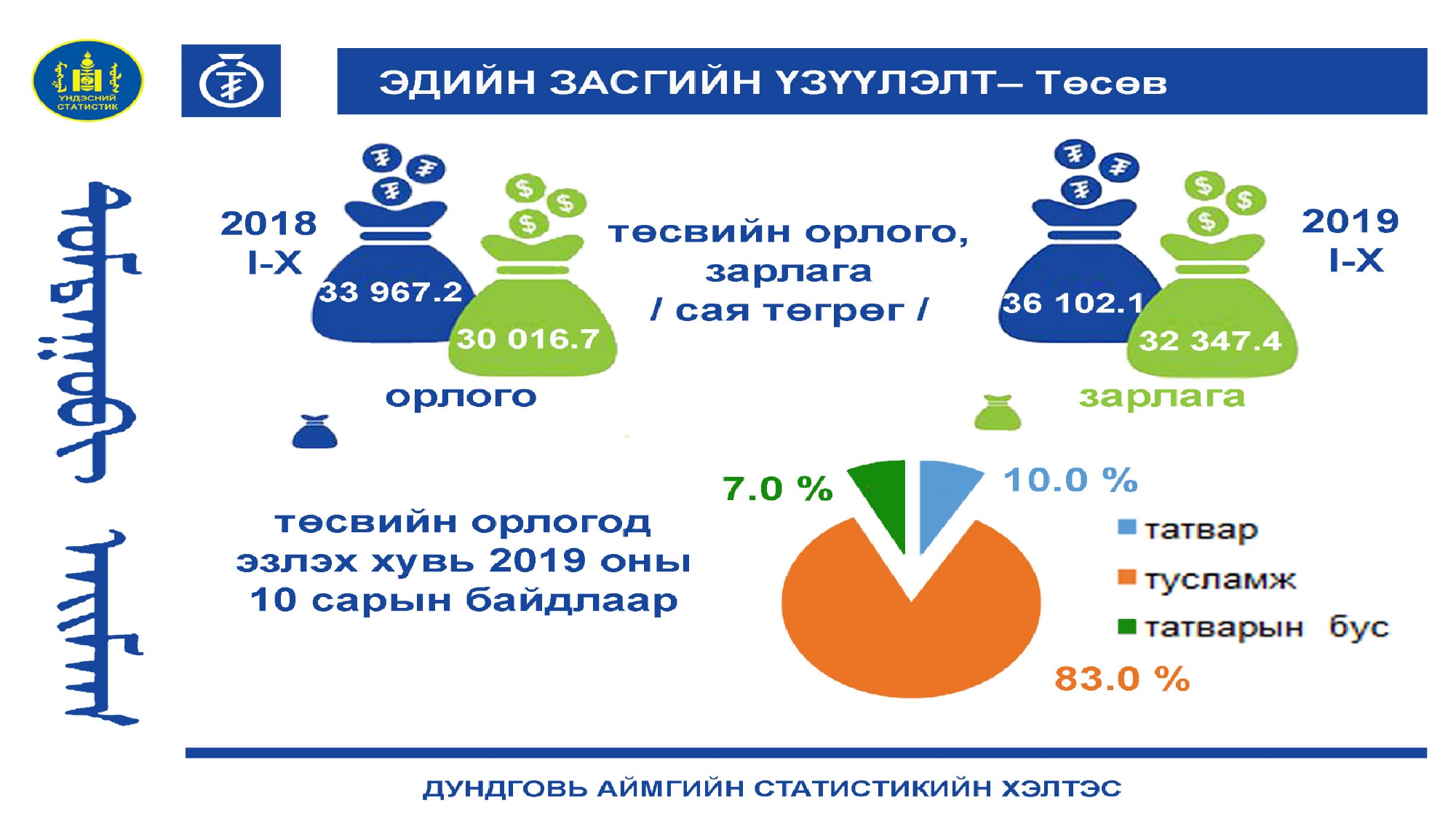
In the pie chart, which is larger: the share of татвар or the share of татварын бус? татвар In the pie chart, what share does татварын бус have? 7.0 % What colour is the тусламж slice in the pie chart? orange Which slice of the pie chart is the smallest? татварын бус In the money-bag graphic, what is the budget revenue (орлого) value for 2019 I-X? 36 102.1 Which slice of the pie chart is the largest? тусламж In the pie chart, what is the difference between the share of татвар and the share of татварын бус? 3.0 % How many slices does the pie chart have? 3 What kind of chart is shown at the bottom right of the slide? pie chart In the pie chart, what share does тусламж have? 83.0 % How many entries does the pie chart legend list? 3 In the pie chart, what share does татвар have? 10.0 %